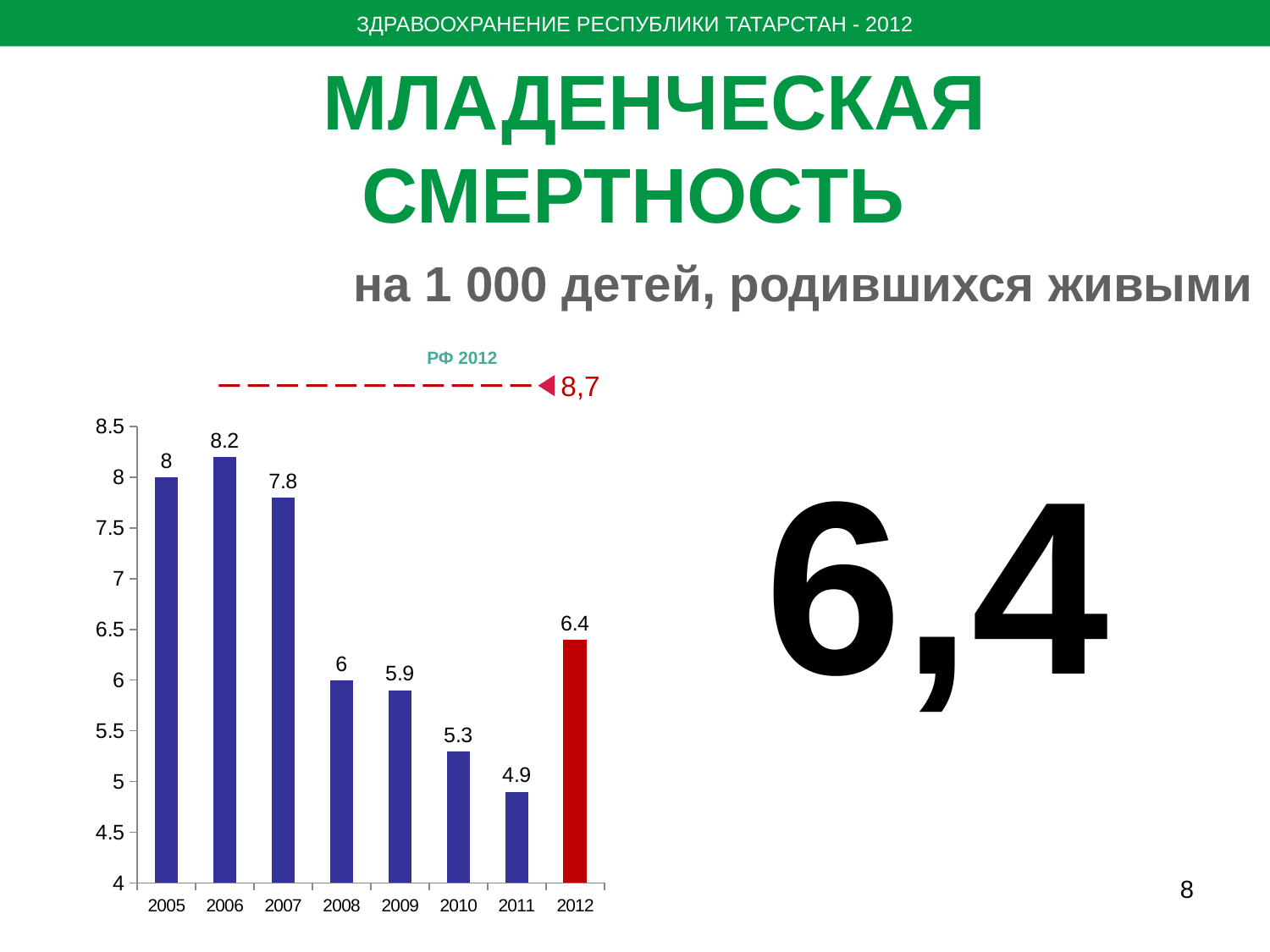
What kind of chart is shown on the slide? bar chart Do the values rise or fall from 2007 to 2011? fall Is the value for 2007 greater or less than 7.5? greater What value is shown for the dashed reference line labelled РФ 2012? 8,7 What is the infant mortality value shown for 2008? 6 What is the value shown for 2012? 6.4 What is the difference between the values for 2006 and 2011? 3.3 Which is larger, the value for 2009 or the value for 2010? 2009 Which year has the highest value on the chart? 2006 How many years are shown on the x axis of the chart? 8 Which year has the lowest value on the chart? 2011 What is the value shown for 2011? 4.9